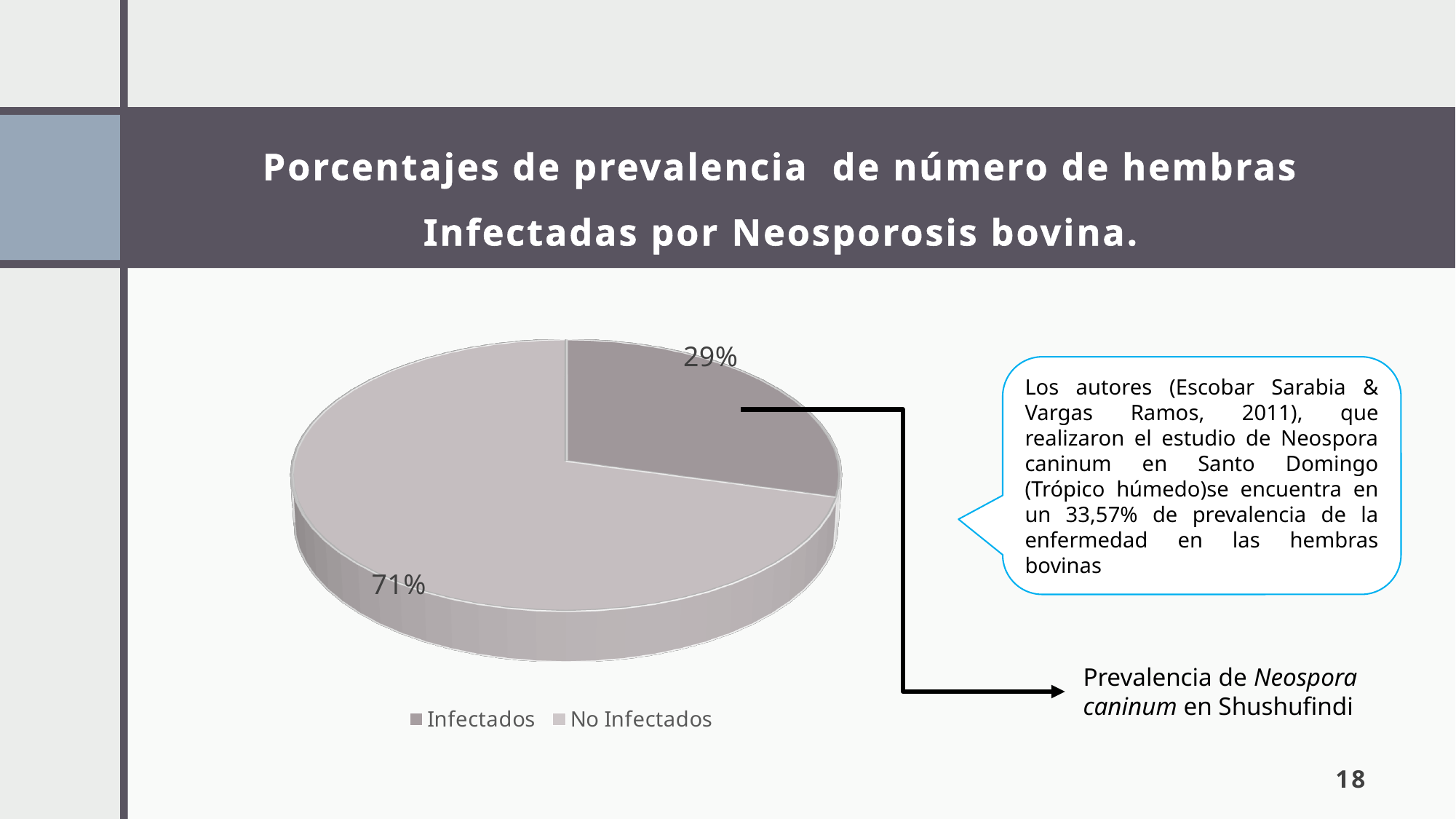
Which category has the smallest slice of the pie chart? Infectados What share of the pie does the Infectados slice represent? 29% What percentage of the pie chart is labelled Infectados? 29% How many entries does the legend of the pie chart list? 2 Which slice is larger, Infectados or No Infectados? No Infectados Which legend entry is shown in the darker grey colour? Infectados What is the difference in percentage points between the No Infectados and Infectados slices? 42 What kind of chart is shown on the slide? Pie chart Which category has the largest slice of the pie chart? No Infectados What percentage of the pie chart is labelled No Infectados? 71% How many slices does the pie chart have? 2 What are the two legend entries of the pie chart? Infectados, No Infectados